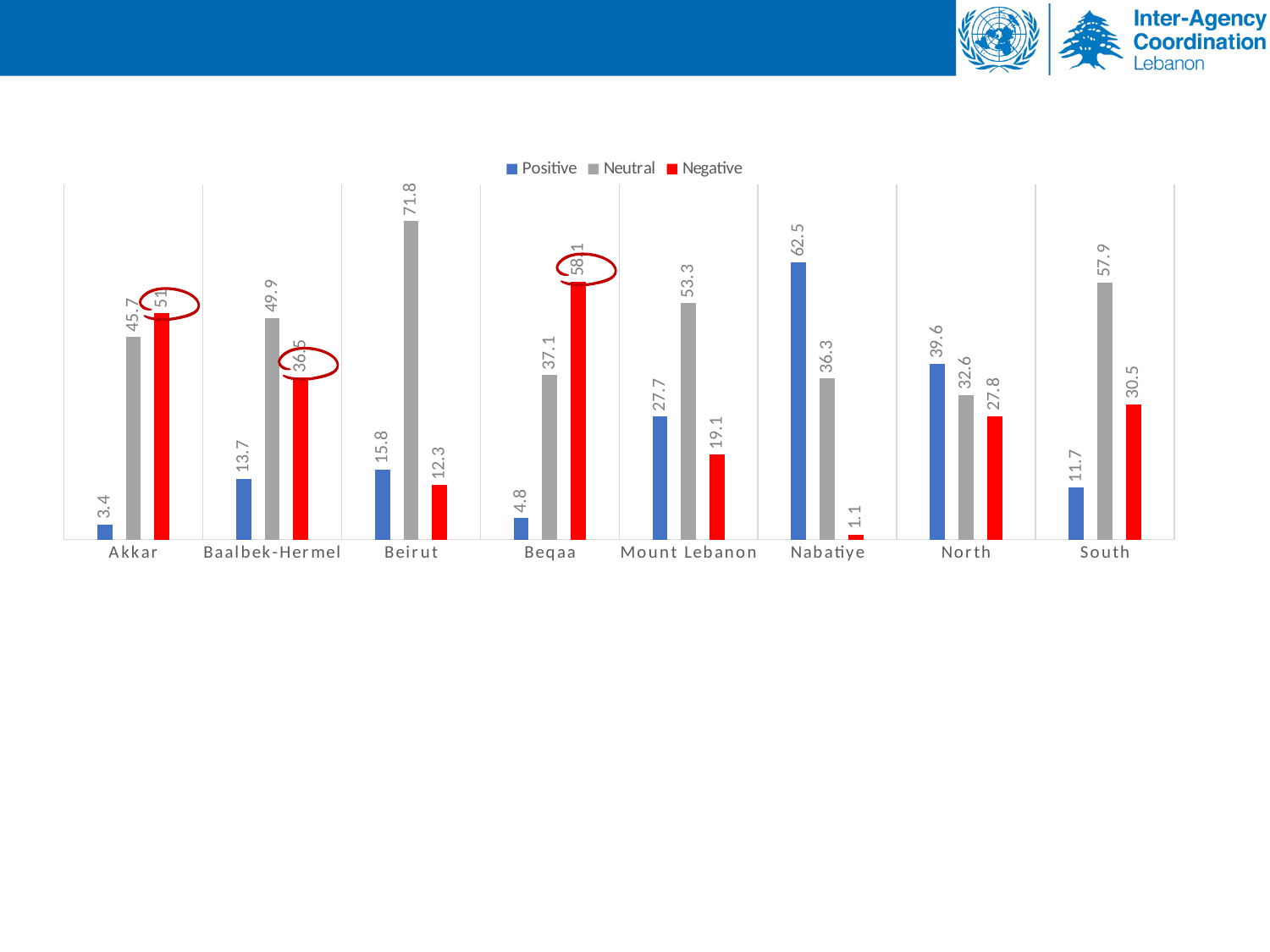
What is the difference between the Neutral and Negative values for Akkar? 5.3 What is the Negative value for Beqaa? 58.1 Which category has the highest Positive value? Nabatiye What is the Positive value for Nabatiye? 62.5 How many categories are shown on the x axis? 8 How many series does the legend list? 3 Which category has the highest Neutral value? Beirut Which category has the lowest Negative value? Nabatiye Which is larger for North: the Positive value or the Neutral value? Positive What is the Neutral value for Beirut? 71.8 What kind of chart is shown on the slide? Bar chart What is the Positive value for Akkar? 3.4